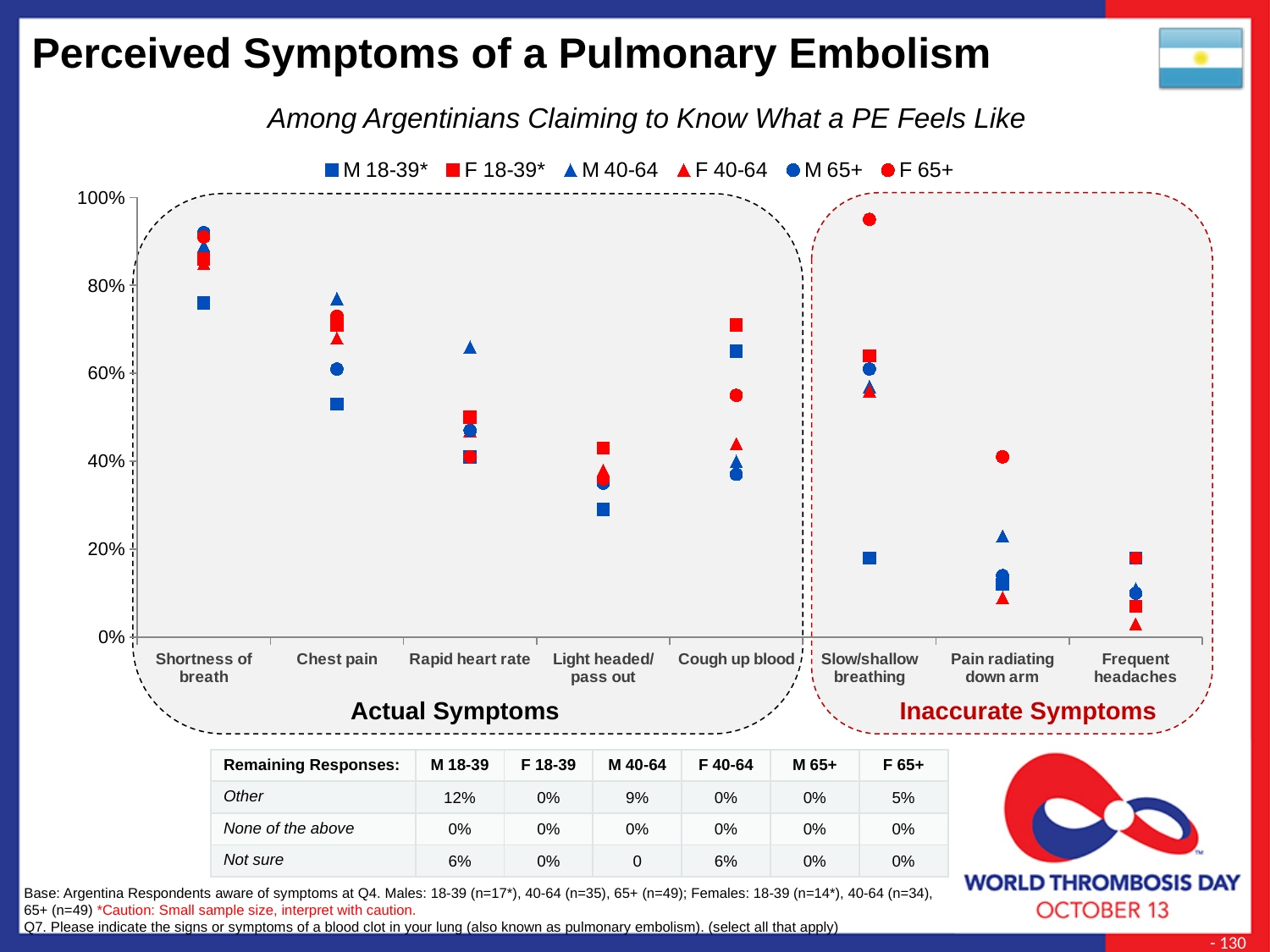
Is the value for M 18-39 on Slow/shallow breathing greater or less than 40%? less What kind of chart is shown on the slide? Scatter chart For M 18-39, which is larger: the value for Shortness of breath or the value for Chest pain? Shortness of breath Is the value for M 18-39 on Light headed/pass out greater or less than 40%? less How many symptom categories are plotted along the x axis? 8 Which symptoms are grouped under the label 'Inaccurate Symptoms'? Slow/shallow breathing, Pain radiating down arm, Frequent headaches Which series has the highest value for Slow/shallow breathing? F 65+ Is the value for F 65+ on Slow/shallow breathing greater or less than 80%? greater Which series has the lowest value for Shortness of breath? M 18-39 How many series does the legend list? 6